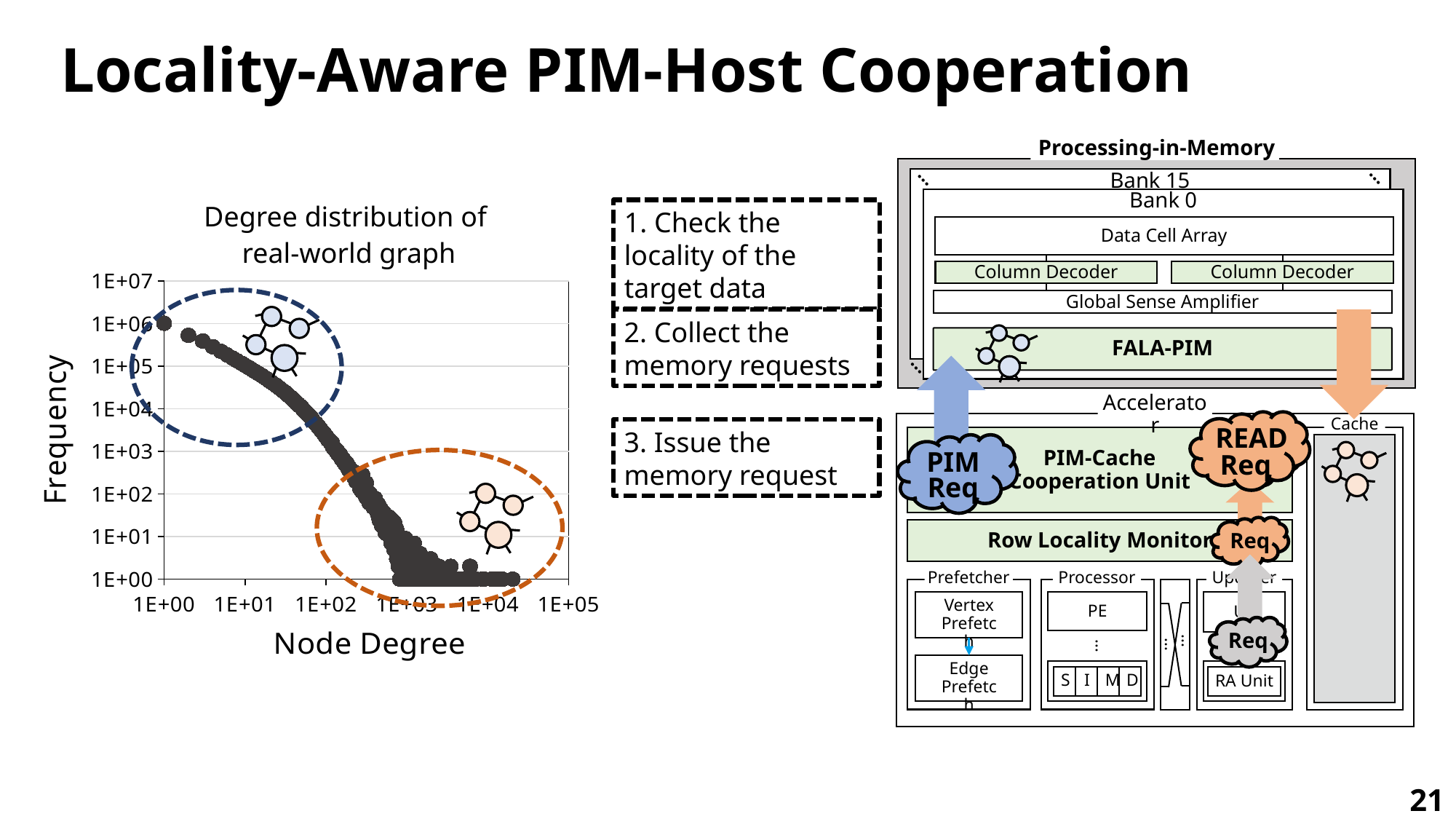
Is the frequency at node degree 1E+01 greater or less than 1E+04? greater What is the title of the chart? Degree distribution of real-world graph Is the frequency at node degree 1E+04 greater or less than 1E+02? less Is the frequency at node degree 1E+00 greater or less than 1E+05? greater What kind of chart is shown on the slide? scatter chart Which has the higher frequency: node degree 1E+01 or node degree 1E+03? 1E+01 At which node degree on the x axis is the frequency highest? 1E+00 What is the label of the x axis of the chart? Node Degree Does frequency rise or fall as node degree increases along the x axis? fall